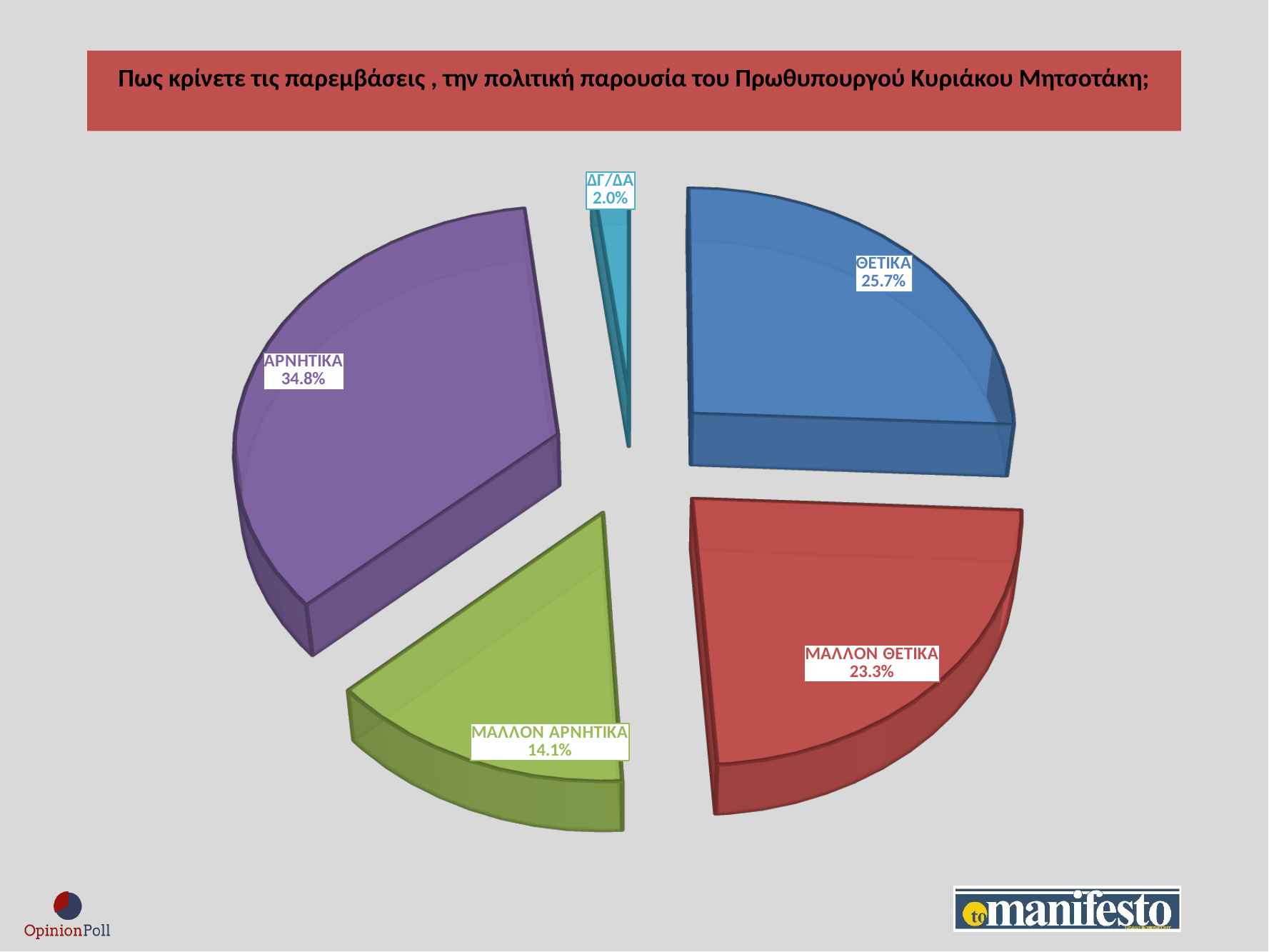
How many slices does the pie chart have? 5 What is the difference in percentage points between ΑΡΝΗΤΙΚΑ and ΘΕΤΙΚΑ? 9.1 What percentage is shown for ΜΑΛΛΟΝ ΘΕΤΙΚΑ? 23.3% Which is larger, ΘΕΤΙΚΑ or ΜΑΛΛΟΝ ΘΕΤΙΚΑ? ΘΕΤΙΚΑ Which category has the smallest share of the pie? ΔΓ/ΔΑ What percentage is shown for ΜΑΛΛΟΝ ΑΡΝΗΤΙΚΑ? 14.1% What percentage is shown for ΑΡΝΗΤΙΚΑ? 34.8% What kind of chart is shown on the slide? pie chart What percentage is shown for ΘΕΤΙΚΑ? 25.7% Which category has the largest share of the pie? ΑΡΝΗΤΙΚΑ What colour is the ΑΡΝΗΤΙΚΑ slice? purple What percentage is shown for ΔΓ/ΔΑ? 2.0%